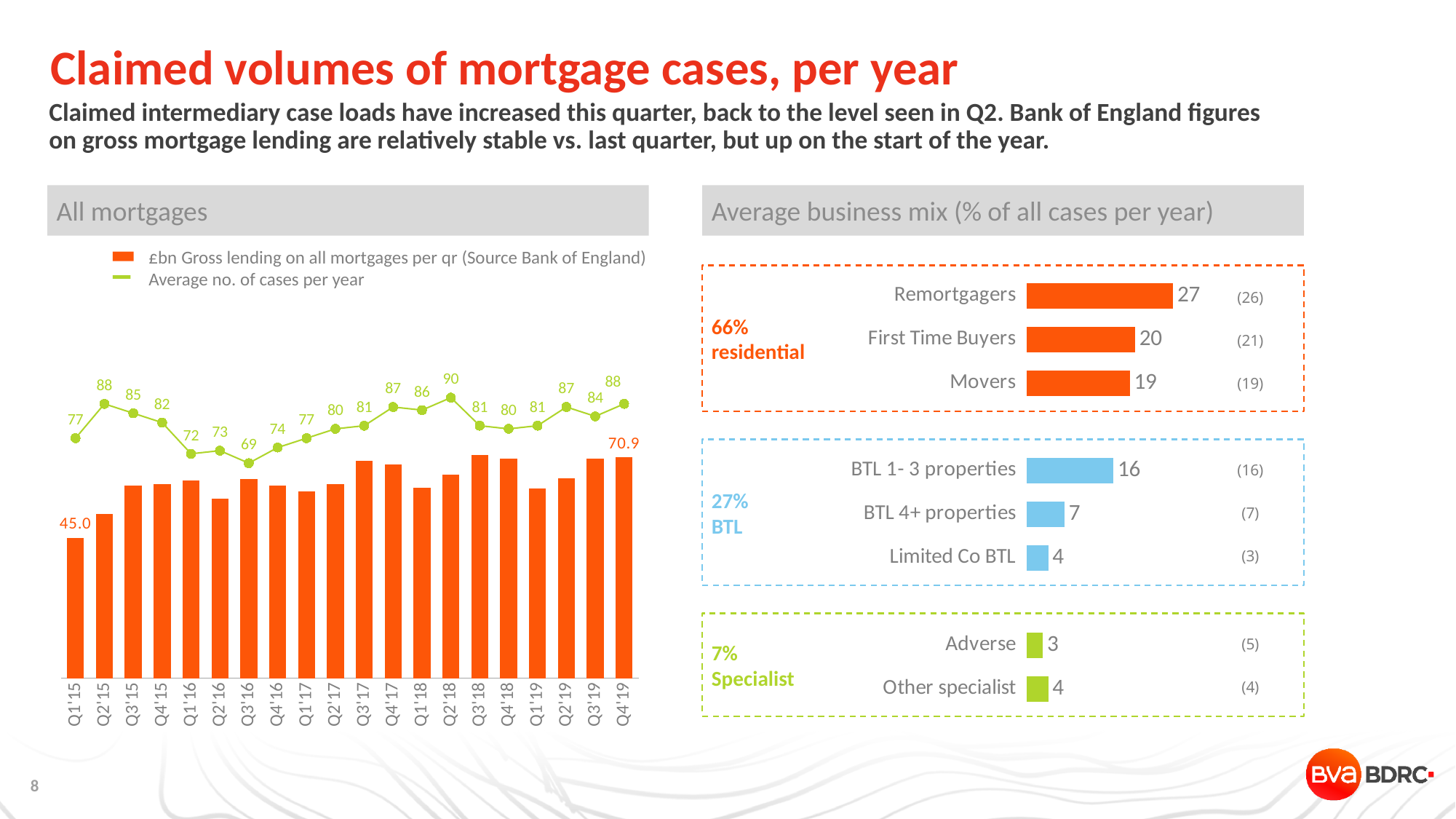
In the 'All mortgages' chart, how many quarters are shown on the x axis? 20 In the 'All mortgages' chart, how many series does the legend list? 2 In the 'All mortgages' chart, is the average number of cases per year higher in Q2'15 or Q1'16? Q2'15 In the 'All mortgages' chart, which quarter has the lowest average number of cases per year? Q3'16 In the 'Average business mix' chart, what percentage of all cases are Remortgagers? 27 In the 'All mortgages' chart, what is the £bn gross lending value labelled for Q4'19? 70.9 In the 'Average business mix' chart, which category has the highest share of cases? Remortgagers In the 'Average business mix' chart, what is the difference between BTL 1- 3 properties and BTL 4+ properties? 9 In the 'All mortgages' chart, what is the difference between the average number of cases per year in Q2'18 and Q3'16? 21 What type of chart is the 'Average business mix' chart? Bar chart In the 'All mortgages' chart, what is the average number of cases per year for Q2'18? 90 In the 'Average business mix' chart, how many categories are shown? 8